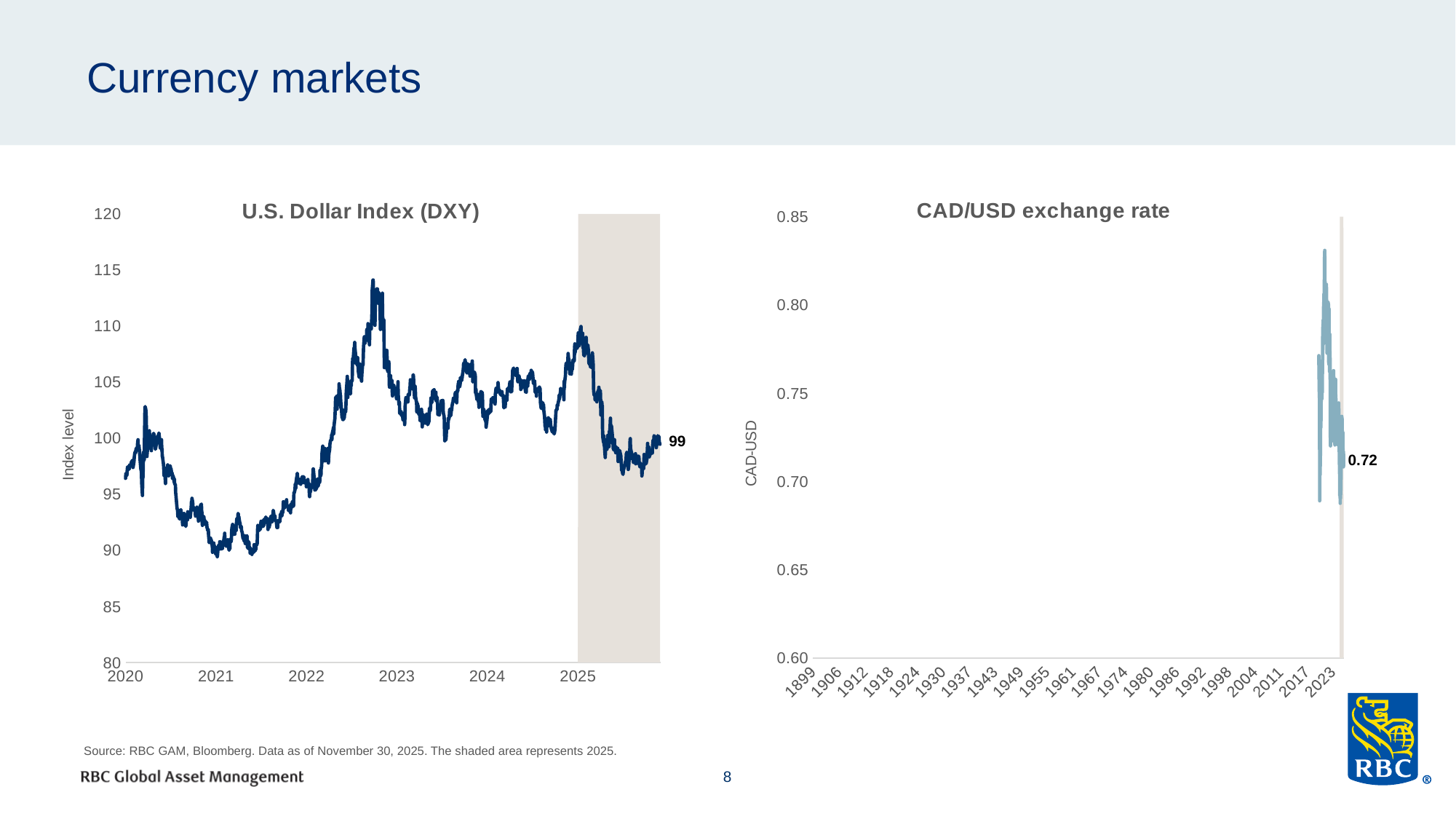
On the CAD/USD exchange rate chart, is the highest value plotted greater or less than 0.80? greater On the CAD/USD exchange rate chart, what is the latest value shown by the data label at the end of the line? 0.72 On the U.S. Dollar Index (DXY) chart, what is the latest value shown by the data label at the end of the line? 99 On the U.S. Dollar Index (DXY) chart, is the peak value reached in late 2022 greater or less than 110? greater What is the y-axis label on the U.S. Dollar Index (DXY) chart? Index level What kind of chart is the U.S. Dollar Index (DXY) chart? Line chart What kind of chart is the CAD/USD exchange rate chart? Line chart On the U.S. Dollar Index (DXY) chart, is the lowest value reached in 2021 greater or less than 95? less What is the y-axis label on the CAD/USD exchange rate chart? CAD-USD On the U.S. Dollar Index (DXY) chart, does the index rise or fall from the start of 2020 to the end of 2020? Fall On the U.S. Dollar Index (DXY) chart, does the index rise or fall over the shaded 2025 period? Fall